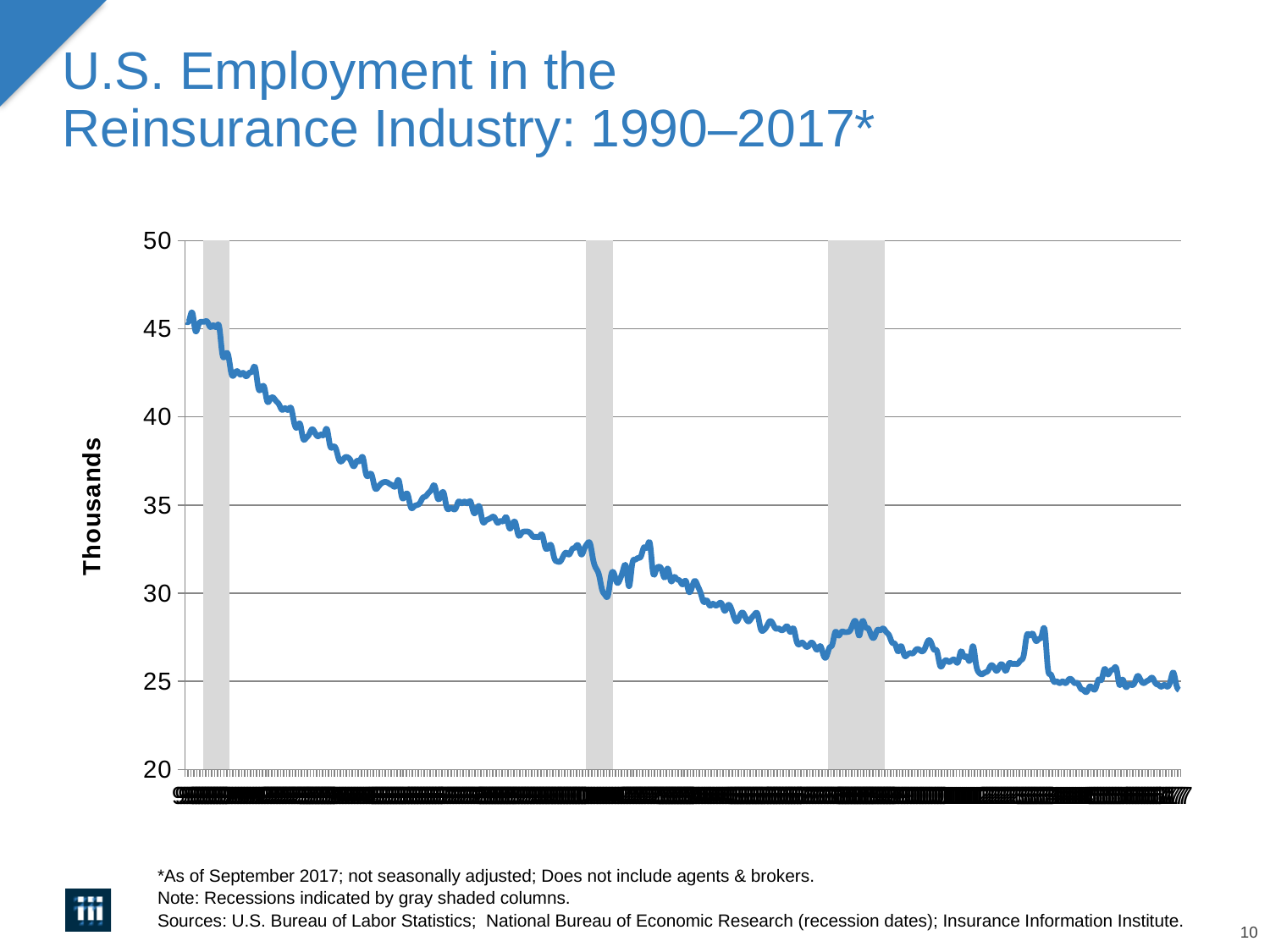
Is the value at the end of the series (2017) greater or less than 30? less Is the value at the start of the series (1990) greater or less than 35? greater What is the highest value shown on the vertical axis of the chart? 50 Do the values in the chart generally rise or fall from 1990 to 2017? fall Is the value at the start of the series (1990) greater or less than 40? greater How many gray shaded recession columns are shown on the chart? 3 What kind of chart is shown on the slide? line chart What is the label on the vertical axis of the chart? Thousands Is the value at the start of the series larger or smaller than the value at the end of the series? larger